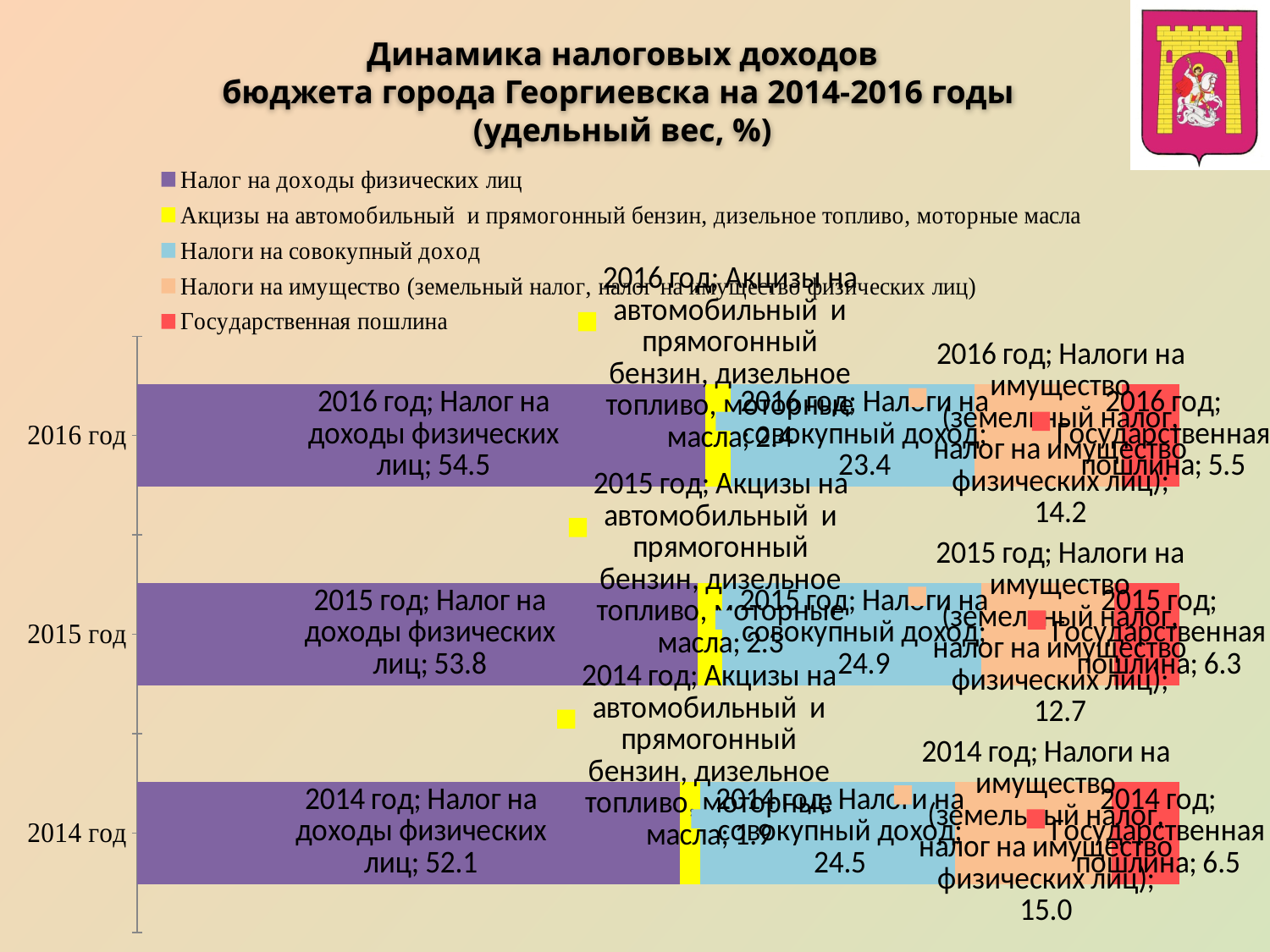
Does the share of Налог на доходы физических лиц rise or fall from 2014 to 2016? rise Which is larger: Налоги на имущество in 2015 or in 2016? 2016 год What is the value for Государственная пошлина in 2014? 6.5 In which year is the share of Налог на доходы физических лиц the highest? 2016 год What is the value for Налог на доходы физических лиц in 2016? 54.5 What is the value for Налоги на имущество in 2014? 15.0 How many years (categories) are shown on the chart? 3 What is the value for Налоги на совокупный доход in 2015? 24.9 In which year is the share of Акцизы на автомобильный и прямогонный бензин, дизельное топливо, моторные масла the lowest? 2014 год What is the difference between the Налог на доходы физических лиц values for 2016 and 2014? 2.4 What type of chart is shown on the slide? stacked bar chart How many series does the legend list? 5